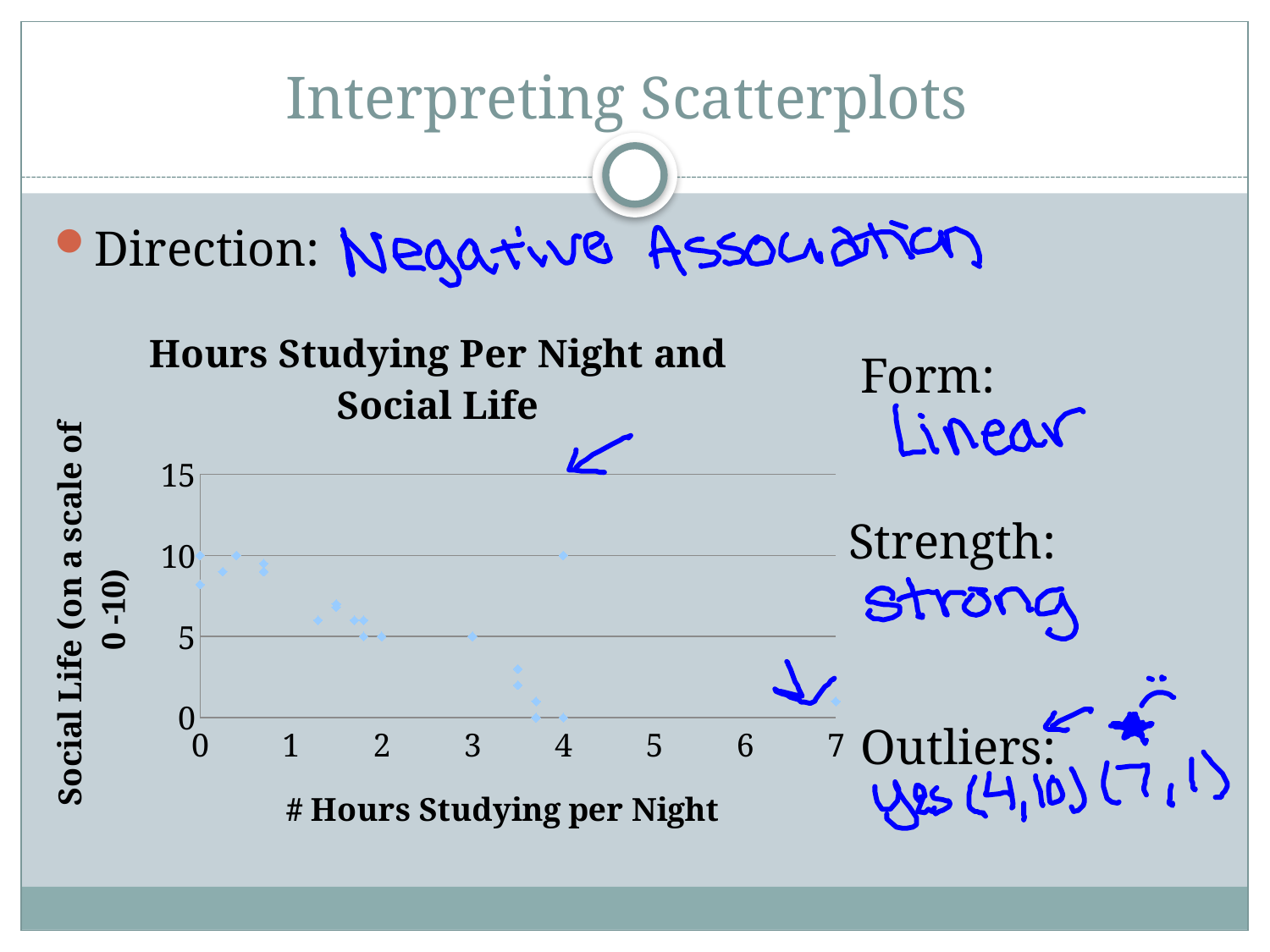
What is the label of the x axis of the chart? # Hours Studying per Night Is the social life value for the point at about 0.3 hours studying greater or less than 5? greater What is the title of the chart? Hours Studying Per Night and Social Life Which has the higher social life value: the point at 0 hours studying or the point at 7 hours studying? the point at 0 hours Are the social life values for the points at about 3.5 hours studying greater or less than 5? less Is the social life value for the point at 0 hours studying greater or less than 5? greater What is the highest value shown on the y axis of the chart? 15 What kind of chart is shown on the slide? scatter plot As the number of hours studying per night increases, do the social life values generally rise or fall? fall